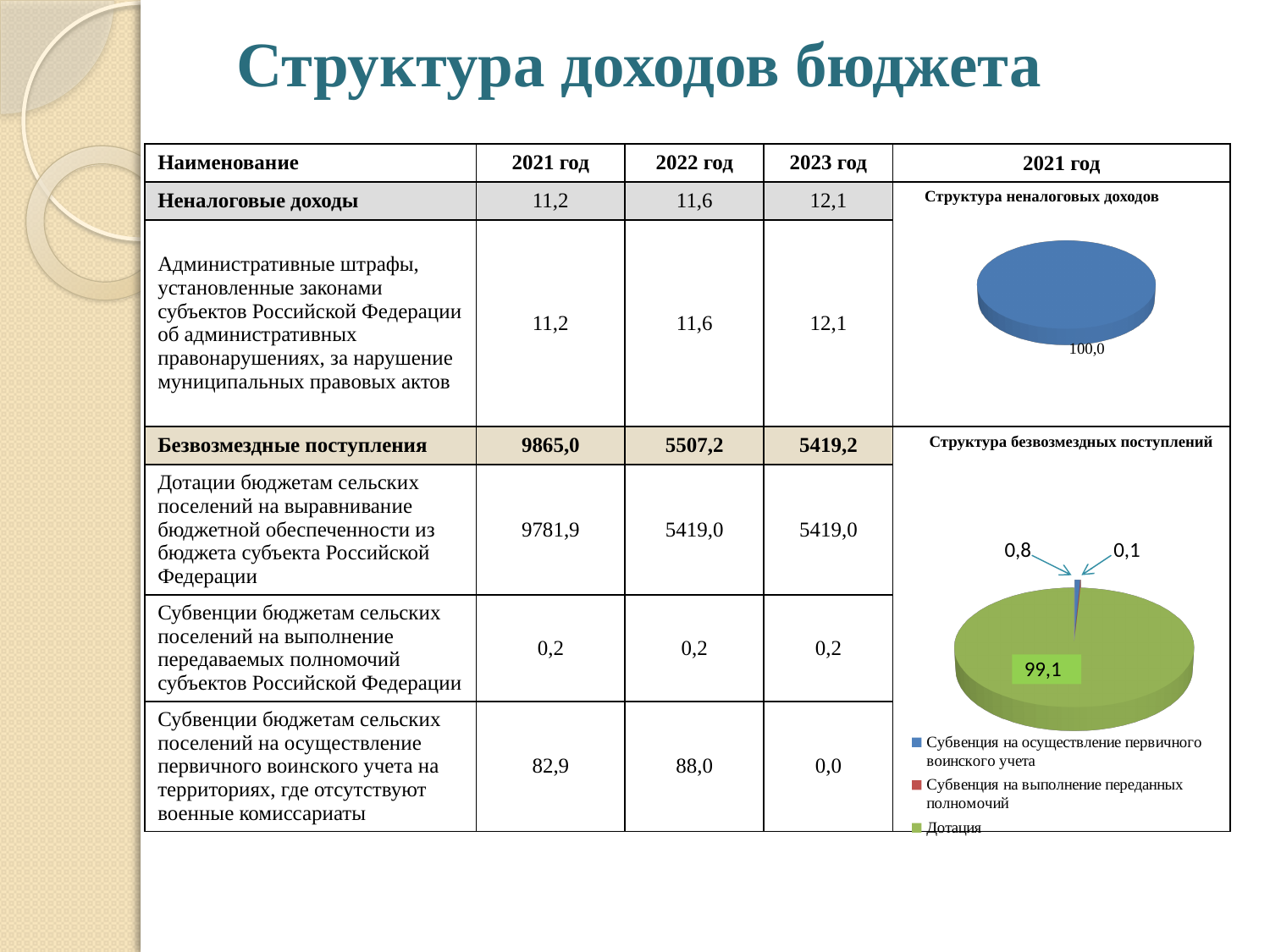
In the "Структура безвозмездных поступлений" chart, what value is shown for Дотация? 99,1 What is the title of the pie chart in the upper right of the slide? Структура неналоговых доходов What kind of chart is the "Структура неналоговых доходов" chart? pie chart How many slices does the "Структура безвозмездных поступлений" chart have? 3 How many slices does the "Структура неналоговых доходов" chart have? 1 What kind of chart is the "Структура безвозмездных поступлений" chart? pie chart In the "Структура безвозмездных поступлений" chart, what is the difference between the largest slice value (99,1) and the slice labelled 0,8? 98,3 In the "Структура безвозмездных поступлений" chart, what colour is the Дотация slice? green How many entries does the legend of the "Структура безвозмездных поступлений" chart list? 3 In the "Структура неналоговых доходов" chart, what value is printed on the single slice? 100,0 In the "Структура безвозмездных поступлений" chart, which category has the largest slice? Дотация In the "Структура безвозмездных поступлений" chart, which is larger: the slice labelled 0,8 or the slice labelled 0,1? 0,8